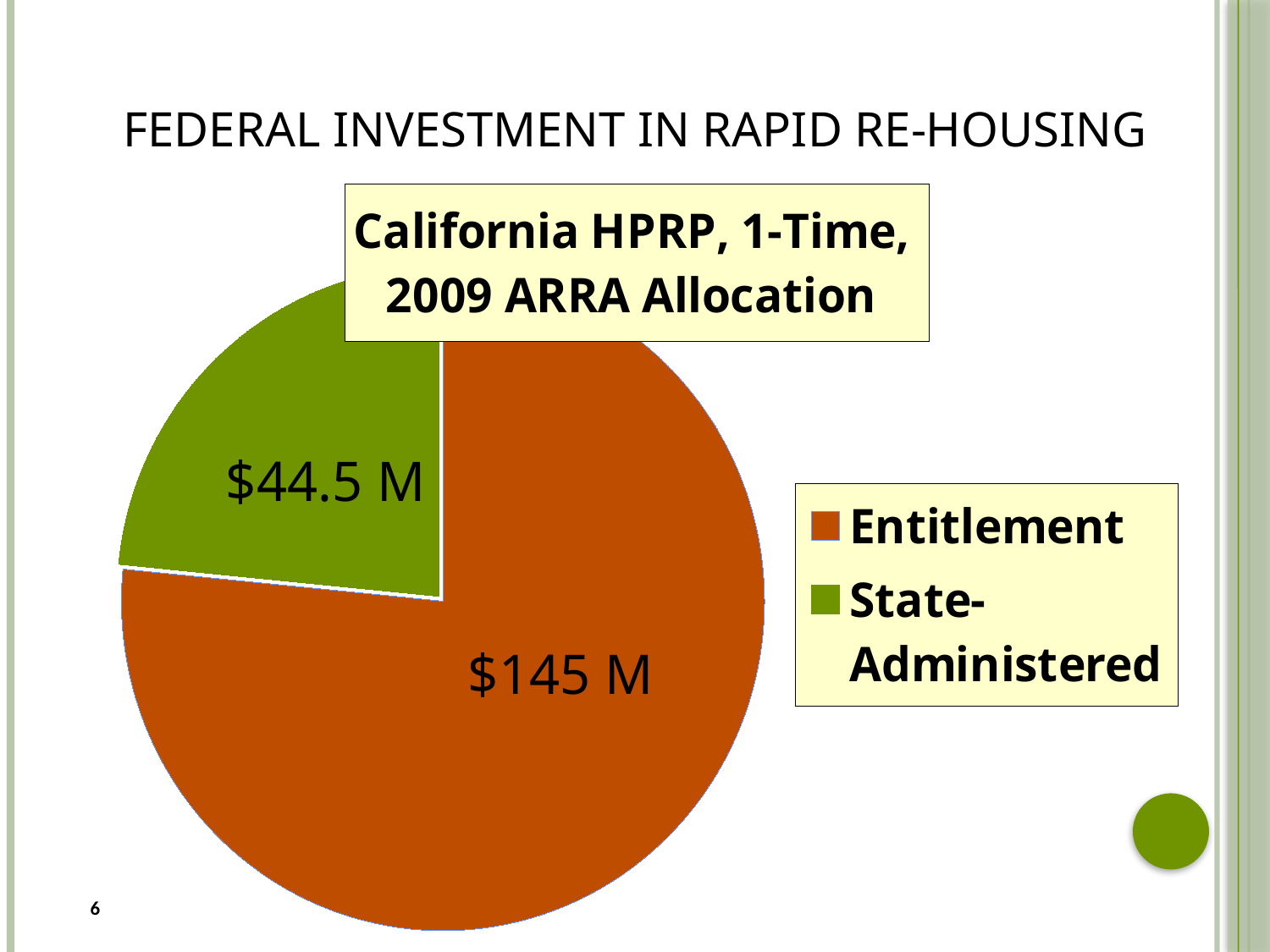
What is the difference between the Entitlement and State-Administered values? $100.5 M What is the value of the State-Administered slice in the pie chart? $44.5 M What is the title of the pie chart? California HPRP, 1-Time, 2009 ARRA Allocation How many slices does the pie chart have? 2 Which is larger, the Entitlement allocation or the State-Administered allocation? Entitlement Which category has the largest slice in the pie chart? Entitlement What is the value of the Entitlement slice in the pie chart? $145 M How many entries does the legend list? 2 What colour is the State-Administered slice in the pie chart? Green What kind of chart is shown on the slide? Pie chart What is the total of the two slices in the pie chart? $189.5 M Which category has the smallest slice in the pie chart? State-Administered